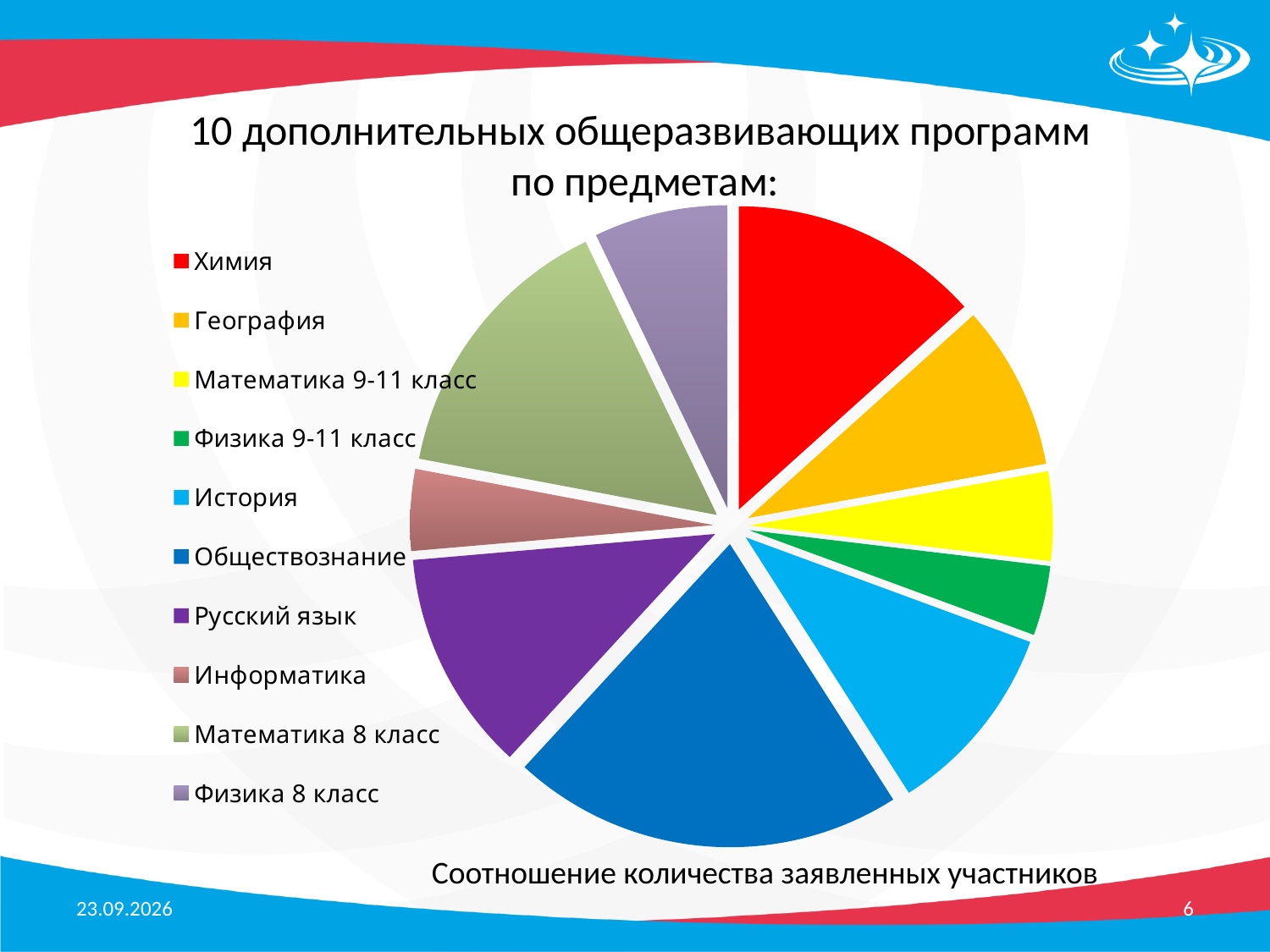
How many entries does the legend of the pie chart list? 10 Which slice is larger: Химия or Физика 9-11 класс? Химия How many slices does the pie chart have? 10 Which slice is larger: Русский язык or Физика 8 класс? Русский язык What colour is the slice for Химия in the pie chart? red What kind of chart is shown on the slide? pie chart Which slice is larger: Обществознание or Химия? Обществознание What is the caption shown below the pie chart? Соотношение количества заявленных участников Which category has the largest slice in the pie chart? Обществознание Which category has the smallest slice in the pie chart? Физика 9-11 класс